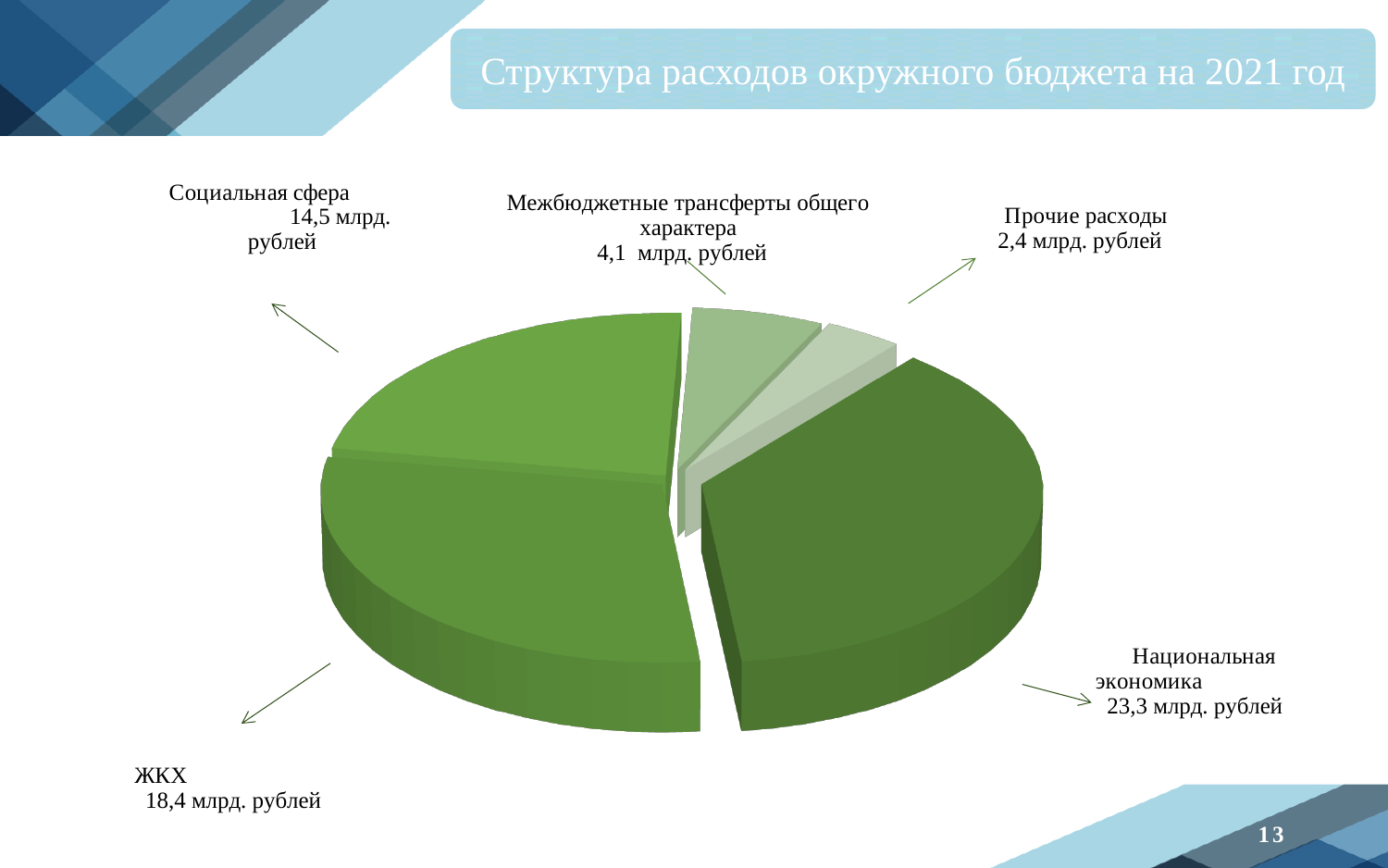
Which category has the smallest value? Прочие расходы What is the value for Прочие расходы? 2,4 млрд. рублей What is the value for Национальная экономика? 23,3 млрд. рублей What is the value for Межбюджетные трансферты общего характера? 4,1 млрд. рублей What kind of chart is shown on the slide? Pie chart What is the difference between Национальная экономика and ЖКХ? 4,9 млрд. рублей What is the value for Социальная сфера? 14,5 млрд. рублей Which category has the largest value? Национальная экономика Which is larger, Социальная сфера or ЖКХ? ЖКХ How many slices does the pie chart have? 5 What is the value for ЖКХ? 18,4 млрд. рублей What is the chart's title? Структура расходов окружного бюджета на 2021 год